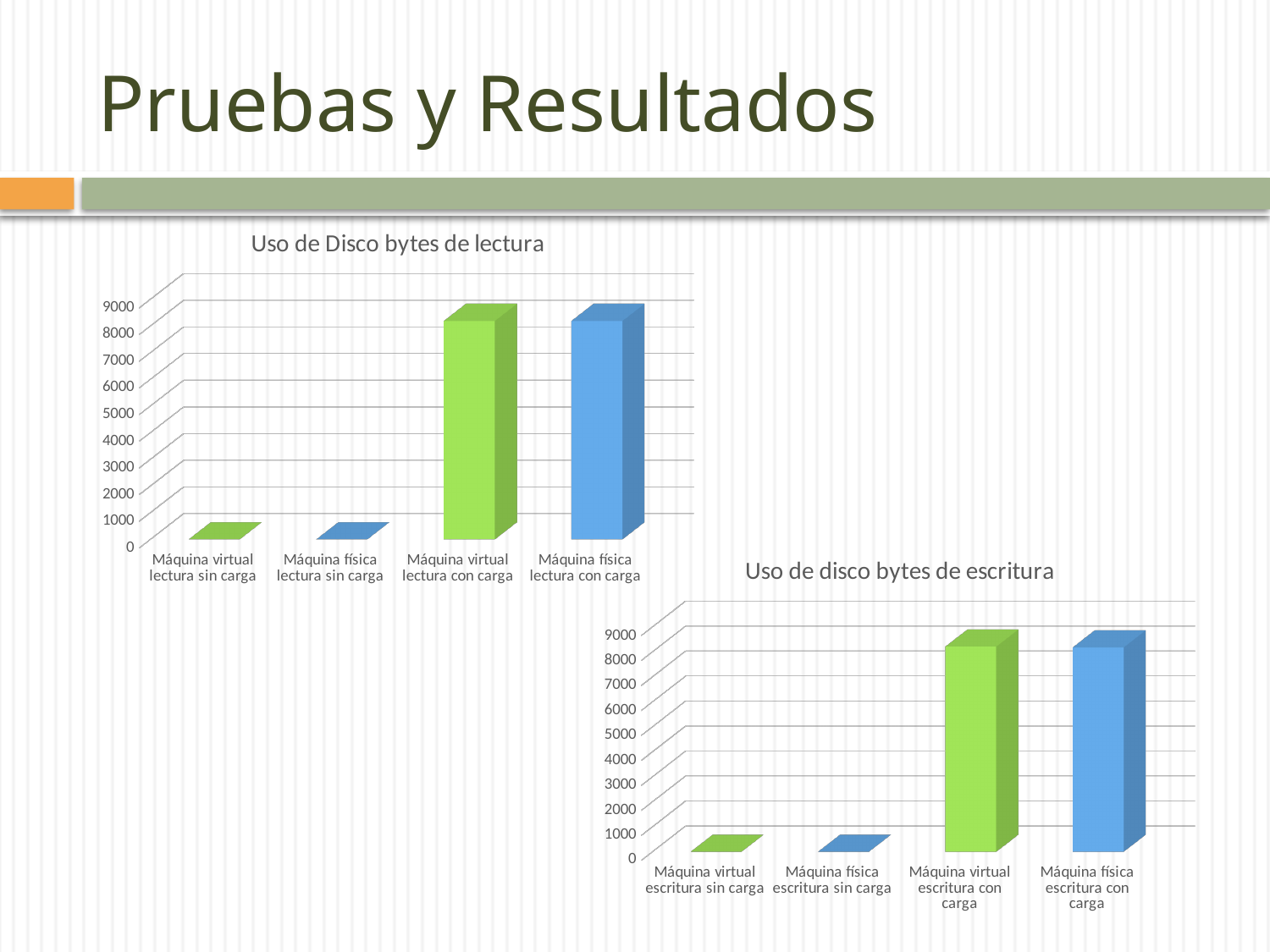
What is the highest value shown on the vertical axis of the 'Uso de Disco bytes de lectura' chart? 9000 In the 'Uso de disco bytes de escritura' chart, is the value for 'Máquina virtual escritura sin carga' greater or less than 2000? less What kind of chart is the 'Uso de Disco bytes de lectura' chart? bar chart In the 'Uso de disco bytes de escritura' chart, which is larger: 'Máquina física escritura con carga' or 'Máquina física escritura sin carga'? Máquina física escritura con carga In the 'Uso de Disco bytes de lectura' chart, is the value for 'Máquina virtual lectura con carga' greater or less than 5000? greater What is the title of the chart in the lower right of the slide? Uso de disco bytes de escritura In the 'Uso de disco bytes de escritura' chart, is the value for 'Máquina física escritura con carga' greater or less than 7000? greater In the 'Uso de Disco bytes de lectura' chart, which is larger: 'Máquina virtual lectura sin carga' or 'Máquina virtual lectura con carga'? Máquina virtual lectura con carga How many categories are shown in the 'Uso de Disco bytes de lectura' chart? 4 How many categories are shown in the 'Uso de disco bytes de escritura' chart? 4